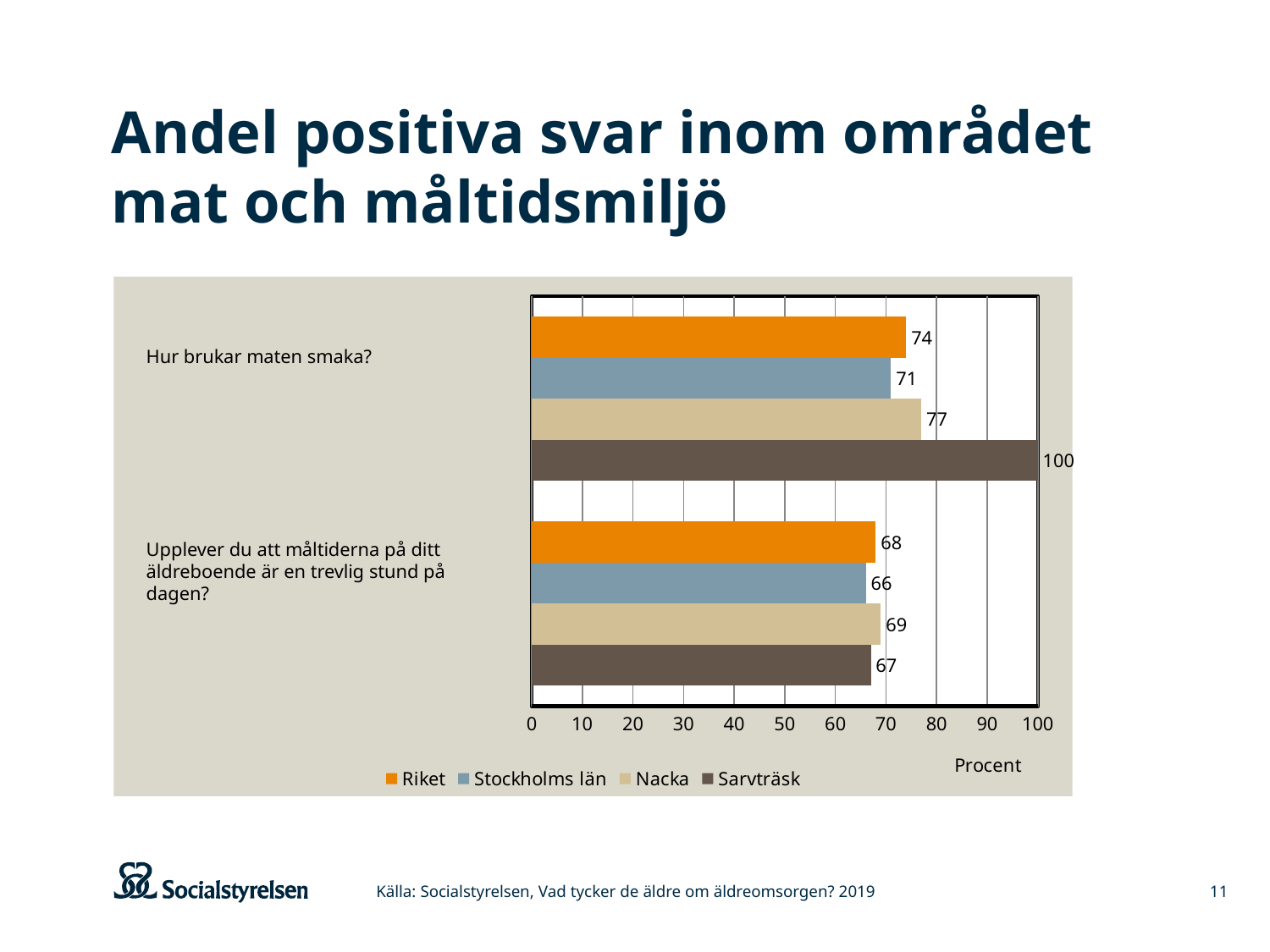
What kind of chart is shown on the slide? Bar chart How many series does the legend list? 4 What is the value for Sarvträsk for the question "Hur brukar maten smaka?"? 100 What is the value for Nacka for the question "Upplever du att måltiderna på ditt äldreboende är en trevlig stund på dagen?"? 69 What is the value for Riket for the question "Upplever du att måltiderna på ditt äldreboende är en trevlig stund på dagen?"? 68 What is the label on the horizontal axis of the chart? Procent What is the value for Stockholms län for the question "Hur brukar maten smaka?"? 71 Which is larger for the question "Hur brukar maten smaka?": the value for Riket or the value for Nacka? Nacka Which series has the highest value for the question "Hur brukar maten smaka?"? Sarvträsk What is the difference between the Sarvträsk value and the Nacka value for the question "Hur brukar maten smaka?"? 23 Which series has the lowest value for the question "Upplever du att måltiderna på ditt äldreboende är en trevlig stund på dagen?"? Stockholms län How many questions (categories) are shown on the chart? 2